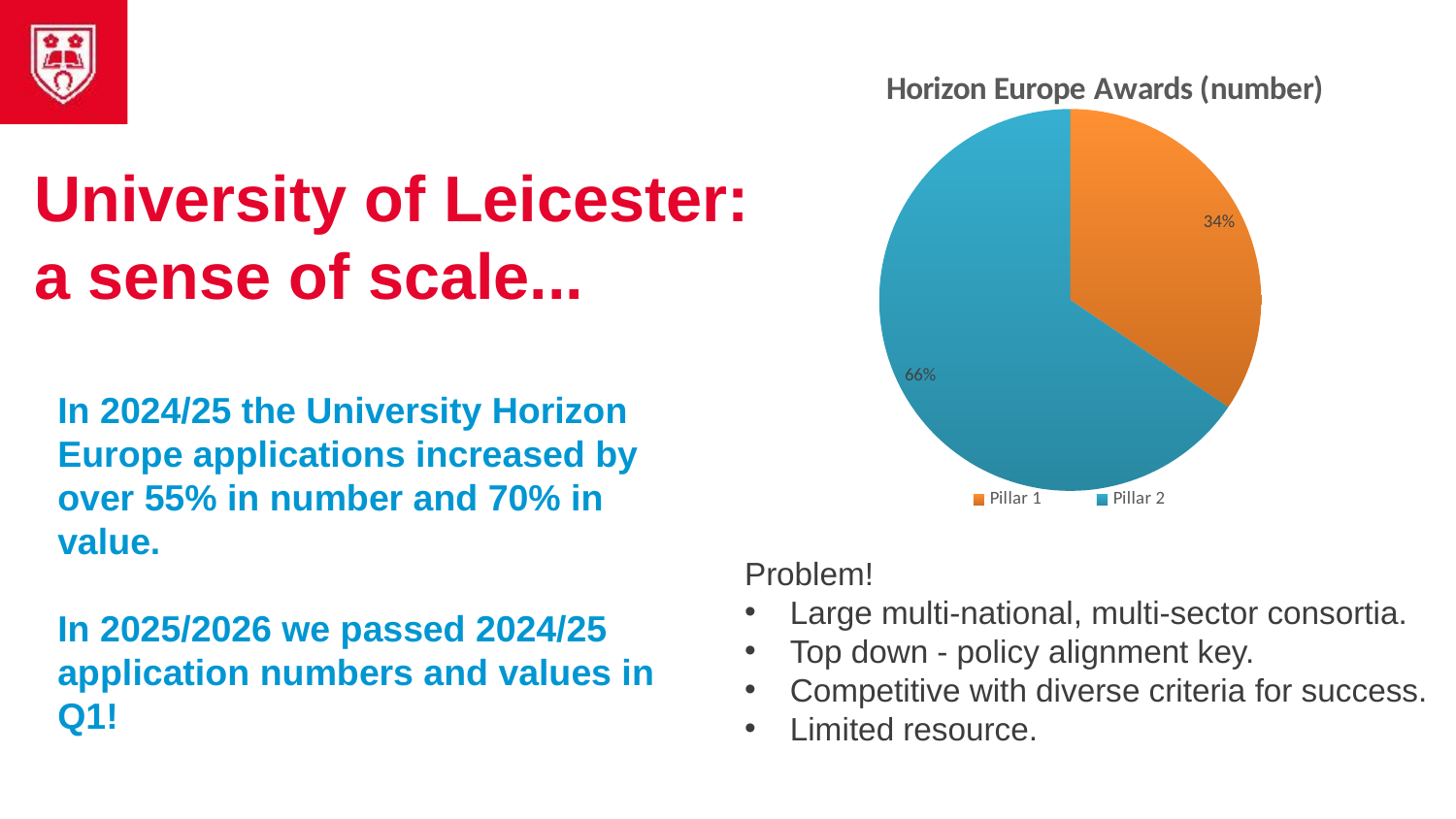
What kind of chart is shown on the slide? pie chart What is the difference in percentage points between the Pillar 2 and Pillar 1 shares? 32 What is the title of the chart? Horizon Europe Awards (number) What share of the pie does Pillar 1 represent? 34% How many entries does the legend list? 2 Which pillar has the smallest share of Horizon Europe awards? Pillar 1 What share of the pie does Pillar 2 represent? 66% Which is larger, the share for Pillar 1 or the share for Pillar 2? Pillar 2 How many slices does the pie chart have? 2 Which pillar has the largest share of Horizon Europe awards? Pillar 2 What colour is the Pillar 1 slice? orange